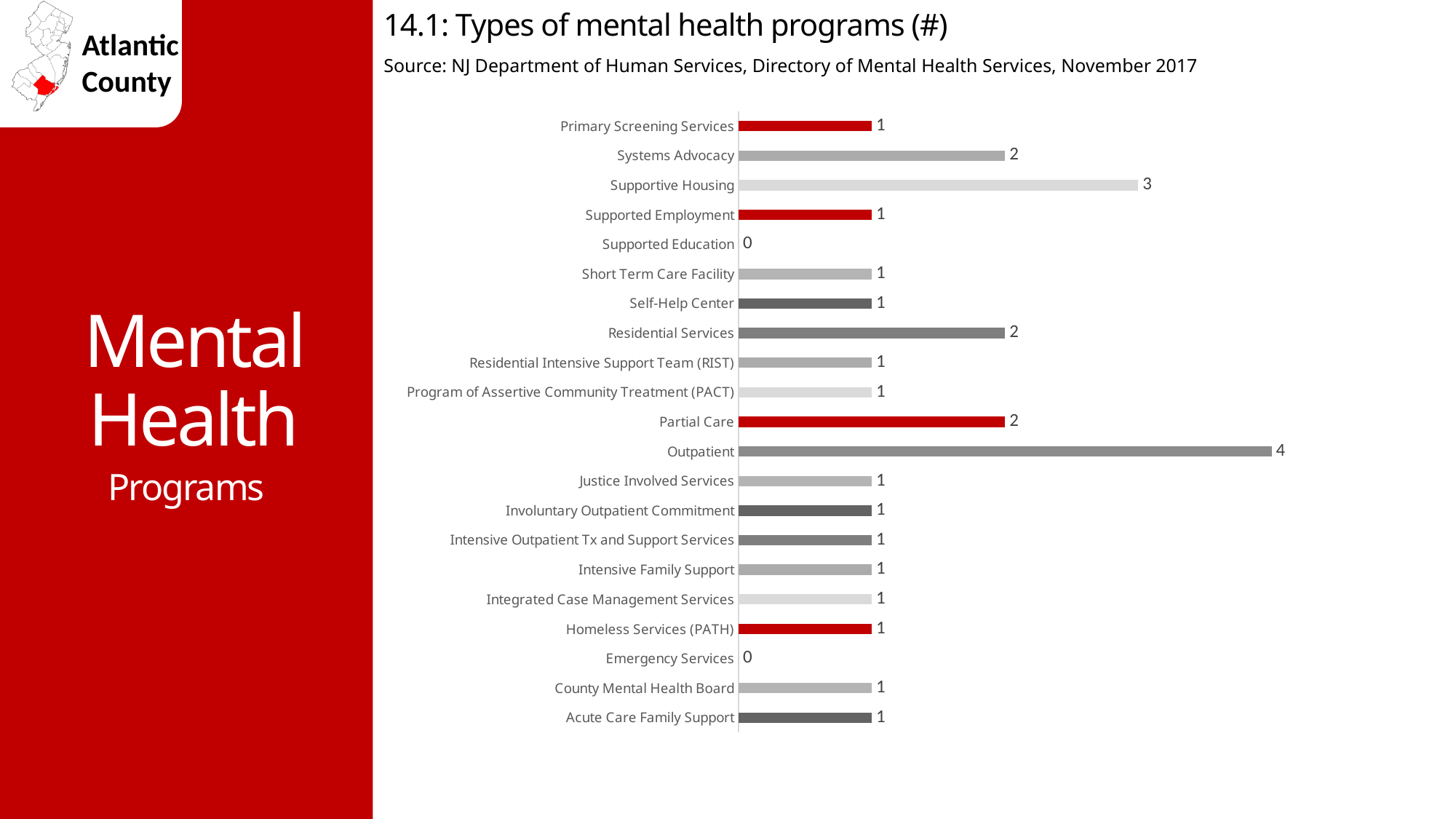
What is the difference between the values for Outpatient and Supportive Housing? 1 How many mental health programs are shown for Outpatient? 4 Which two categories have a value of 0? Supported Education and Emergency Services How many categories are shown in the chart? 21 What is the difference between the values for Residential Services and Self-Help Center? 1 What is the title of the chart? 14.1: Types of mental health programs (#) Which category has the highest number of programs? Outpatient What is the value for Supportive Housing? 3 What is the value for Partial Care? 2 Which is larger, the value for Systems Advocacy or the value for Primary Screening Services? Systems Advocacy What is the value for Emergency Services? 0 What type of chart is shown on the slide? Bar chart